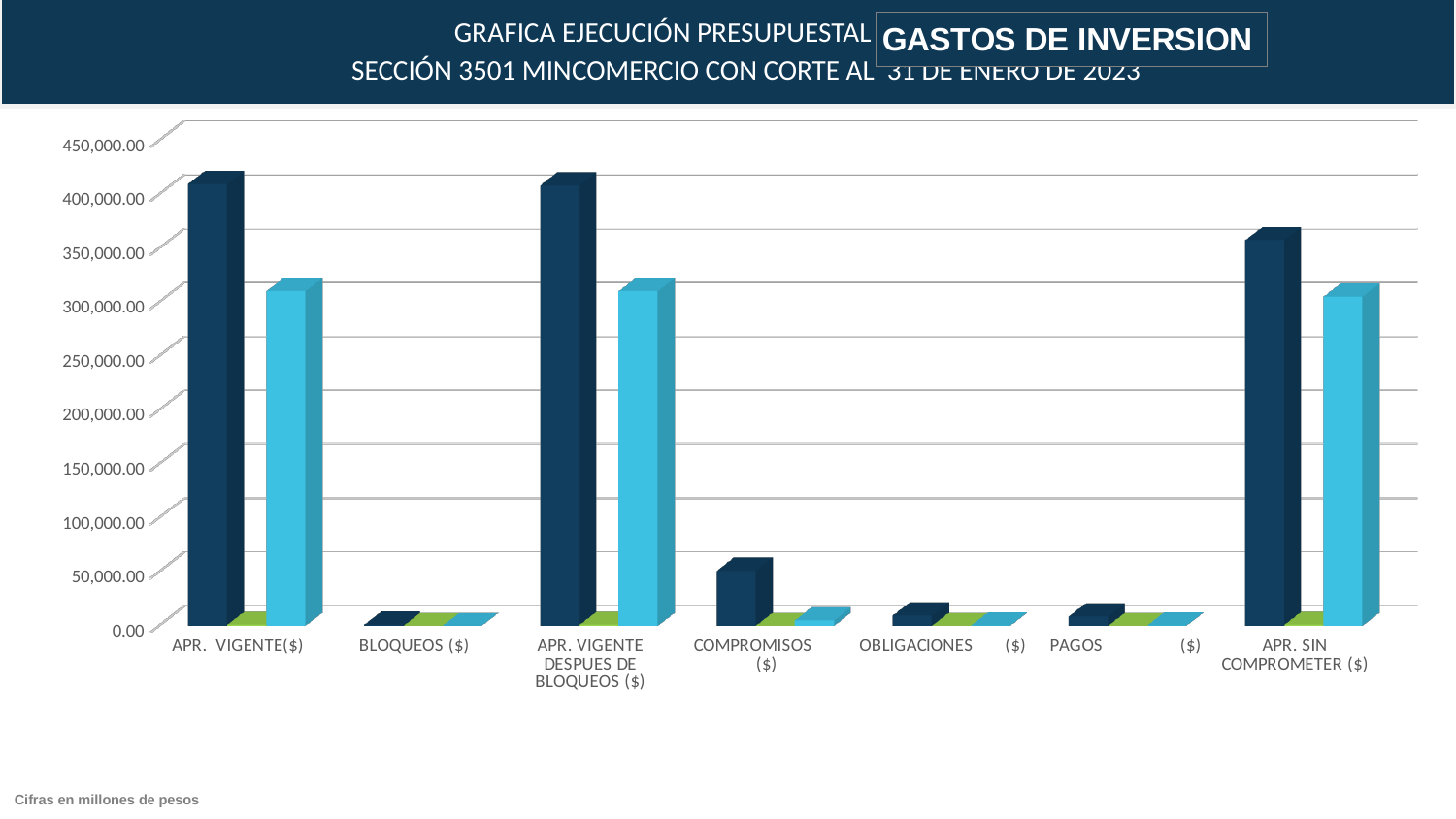
According to the note at the bottom of the slide, in what units are the figures expressed? millones de pesos Is the dark blue bar for PAGOS ($) greater or less than 50,000.00? less For APR. VIGENTE($), which bar is taller, the dark blue one or the light blue one? the dark blue one What kind of chart is shown on the slide? bar chart Is the dark blue bar for APR. VIGENTE($) greater or less than 350,000.00? greater Is the light blue bar for APR. VIGENTE($) greater or less than 250,000.00? greater Which has the larger dark blue bar, COMPROMISOS ($) or APR. SIN COMPROMETER ($)? APR. SIN COMPROMETER ($) What is the highest value shown on the vertical axis of the chart? 450,000.00 How many categories are shown along the x axis of the chart? 7